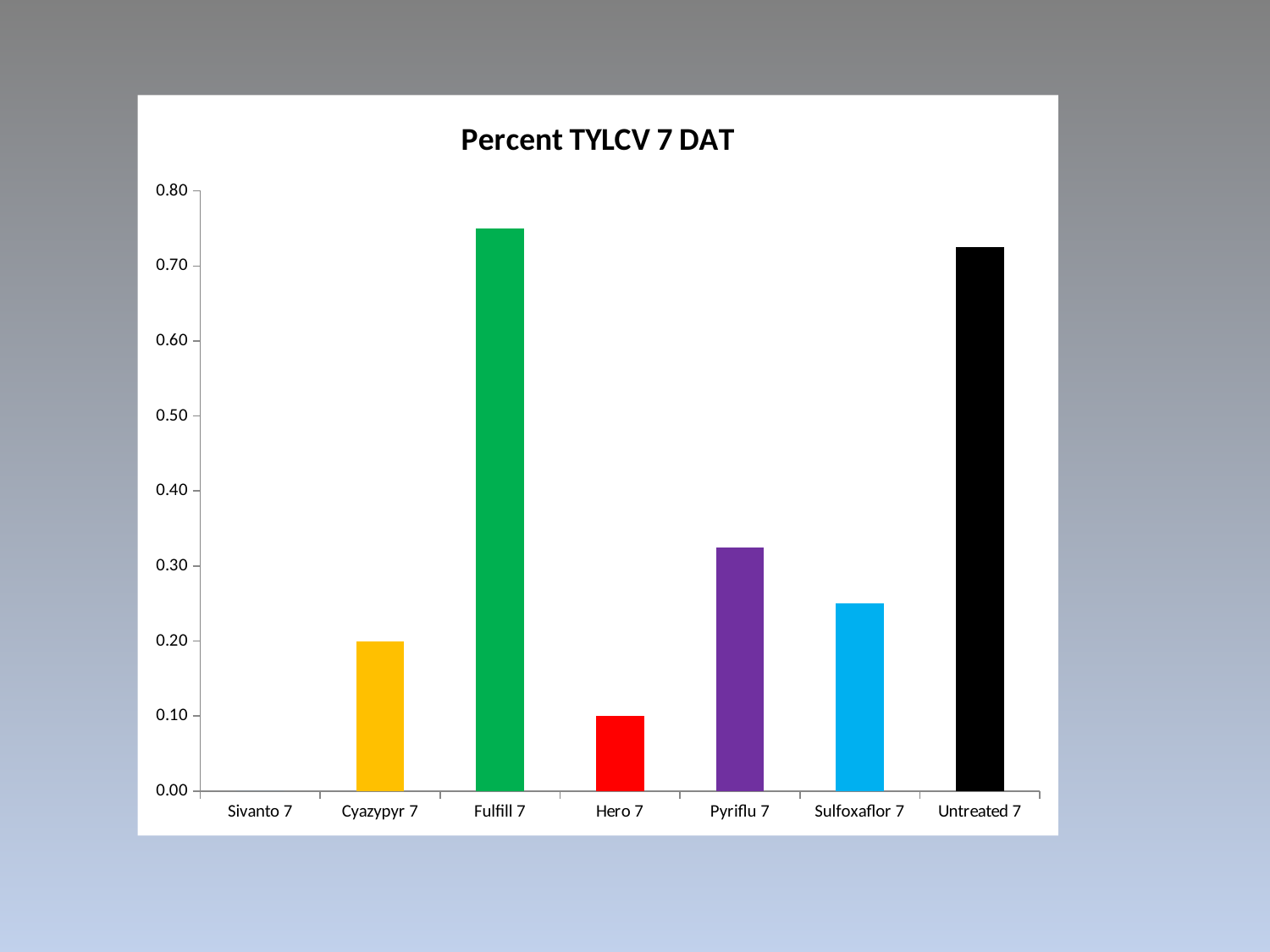
Which category has the lowest value in the chart? Sivanto 7 What is the value for Hero 7? 0.10 What kind of chart is shown on the slide? bar chart How many categories are shown on the x axis of the chart? 7 What is the value for Cyazypyr 7? 0.20 Is the value for Sulfoxaflor 7 greater or less than 0.30? less Is the value for Untreated 7 greater or less than 0.70? greater Which category has the highest value in the chart? Fulfill 7 What is the title of the chart? Percent TYLCV 7 DAT Which is larger, the value for Pyriflu 7 or the value for Sulfoxaflor 7? Pyriflu 7 What colour is the bar for Fulfill 7? green What is the difference between the values for Cyazypyr 7 and Hero 7? 0.10